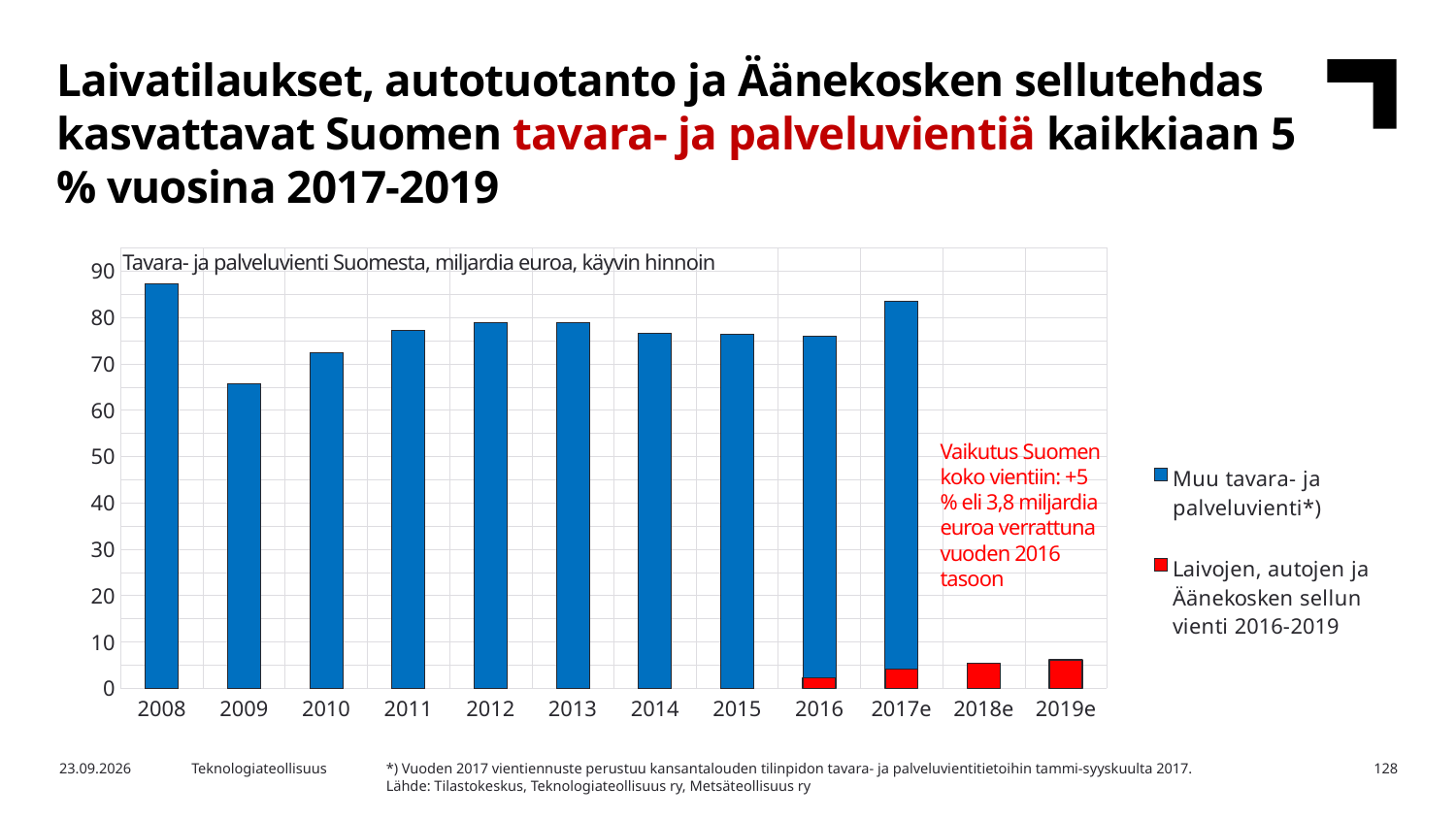
Which year has the tallest bar in the chart? 2008 What kind of chart is shown on the slide? bar chart Is the value for 'Laivojen, autojen ja Äänekosken sellun vienti 2016-2019' in 2018e greater or less than 10? less How many years are shown on the x axis of the chart? 12 What is the title shown inside the chart area? Tavara- ja palveluvienti Suomesta, miljardia euroa, käyvin hinnoin How many series does the chart legend list? 2 Which year has the lowest value for 'Muu tavara- ja palveluvienti*)' among the years where that series is plotted? 2009 Is the total bar value for 2008 greater or less than 80? greater Is the total bar value for 2009 greater or less than 70? less Which year has the larger total bar, 2016 or 2017e? 2017e Which colour represents 'Laivojen, autojen ja Äänekosken sellun vienti 2016-2019' in the chart? red Do the bar values rise or fall from 2008 to 2009? fall